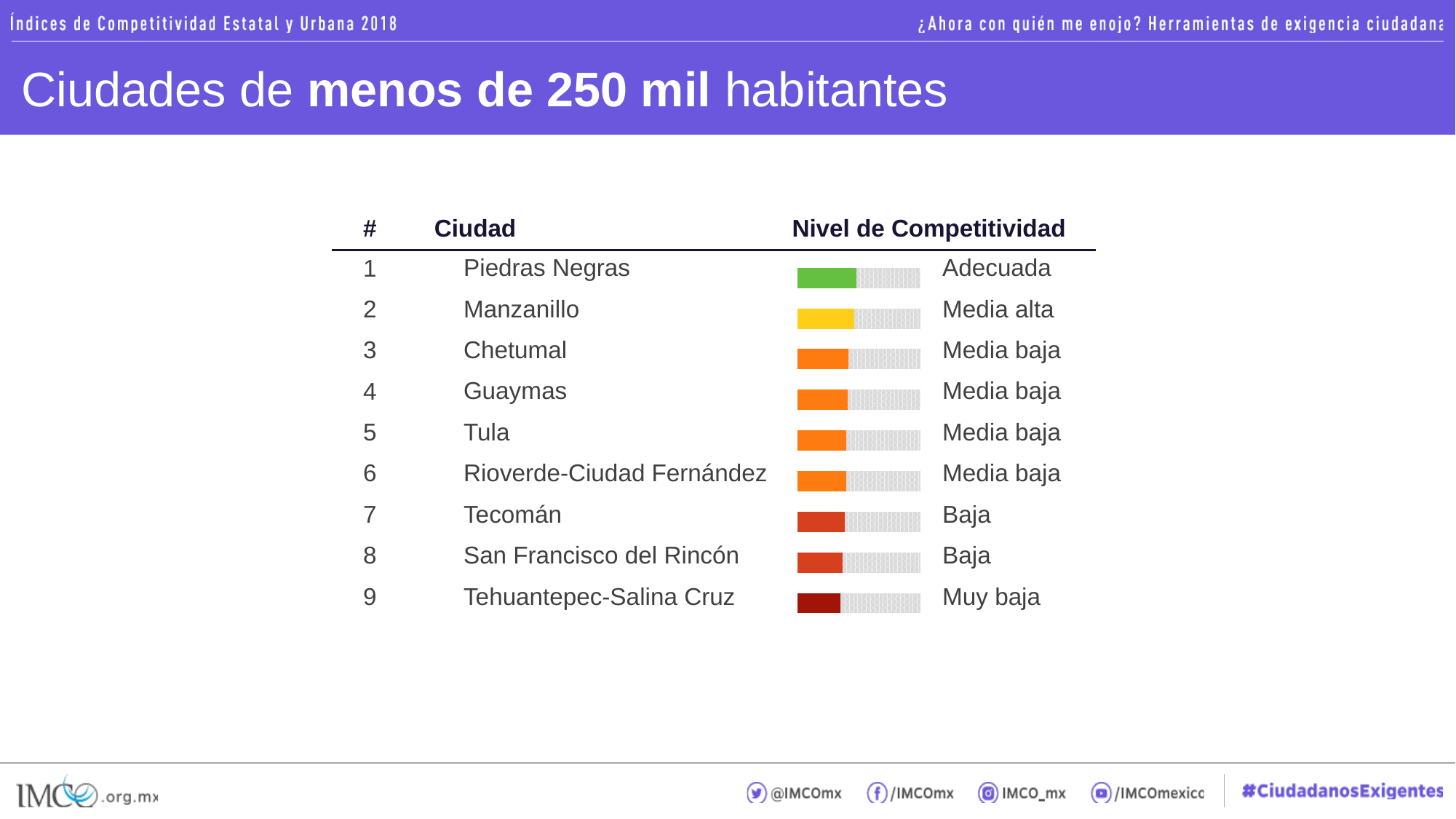
What is the title of the slide? Ciudades de menos de 250 mil habitantes What competitiveness level is shown for San Francisco del Rincón? Baja Which city is ranked number 1 in the table? Piedras Negras Which city is ranked last (number 9) in the table? Tehuantepec-Salina Cruz What colour is the bar for the city with the "Adecuada" level? Green What competitiveness level (Nivel de Competitividad) is shown for Piedras Negras? Adecuada How many cities are listed in the table? 9 What competitiveness level is shown for Tehuantepec-Salina Cruz? Muy baja How many cities have the level "Media baja"? 4 How many cities have the level "Baja"? 2 Which city is ranked higher, Tula or Tecomán? Tula What competitiveness level is shown for Manzanillo? Media alta